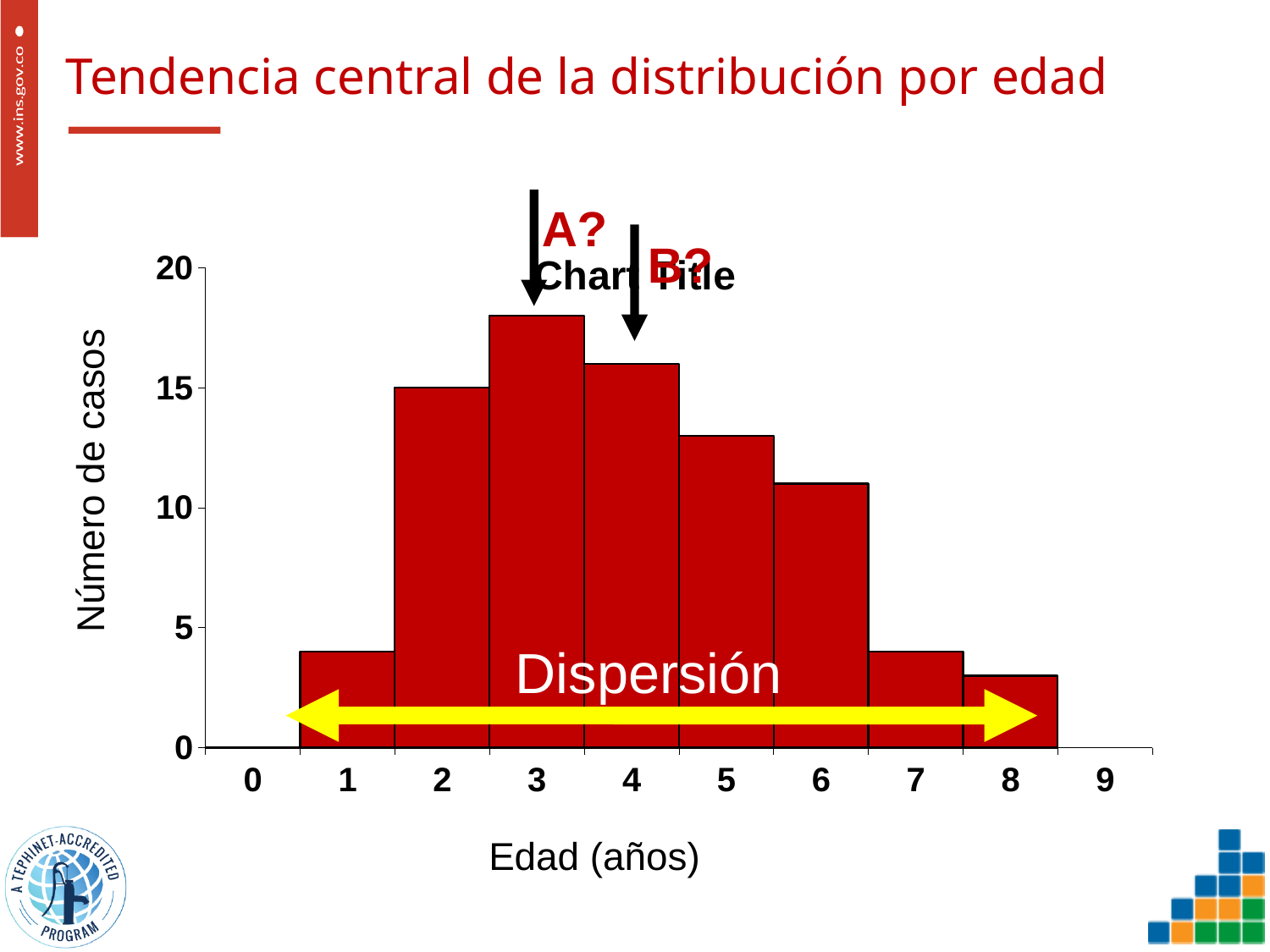
What is the number of cases for age 2? 15 Which age has the highest number of cases? 3 What type of chart is shown on the slide? bar chart Is the value for age 8 greater or less than 5? less Do the values rise or fall from age 3 to age 8? fall Which has more cases, age 4 or age 5? age 4 Is the value for age 7 greater or less than 5? less What is the label of the y axis? Número de casos What is the label of the x axis? Edad (años) Is the value for age 3 greater or less than 15? greater Which has more cases, age 2 or age 6? age 2